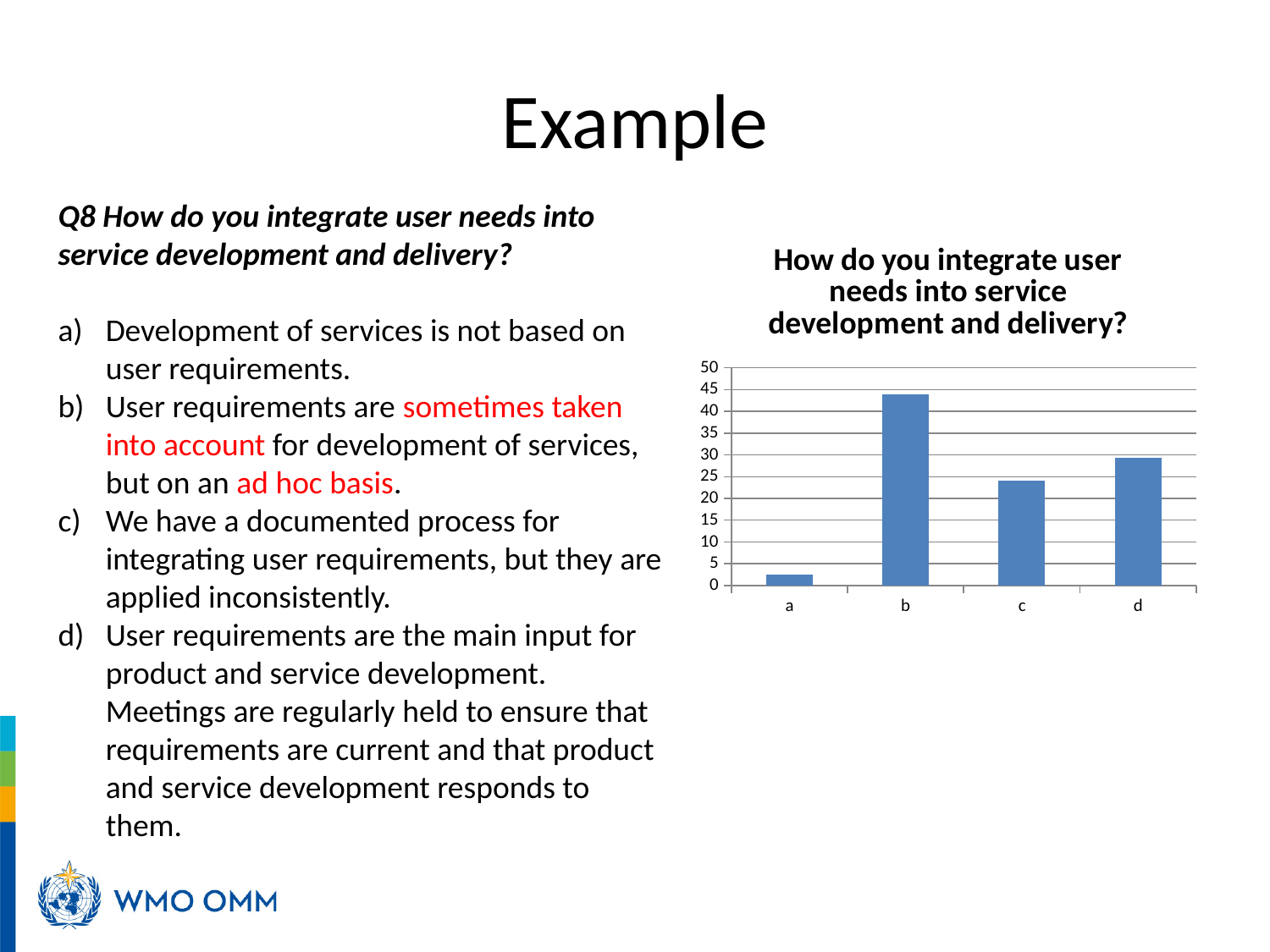
Is the value for a greater or less than 5? less What is the highest value shown on the y axis of the chart? 50 Is the value for d greater or less than 25? greater How many categories are shown on the x axis of the chart? 4 Is the value for c greater or less than 20? greater Which category has the highest bar in the chart? b What kind of chart is shown on the slide? bar chart Which category has the lowest bar in the chart? a Which is larger, the value for b or the value for d? b What is the title of the chart? How do you integrate user needs into service development and delivery? Which is larger, the value for c or the value for d? d